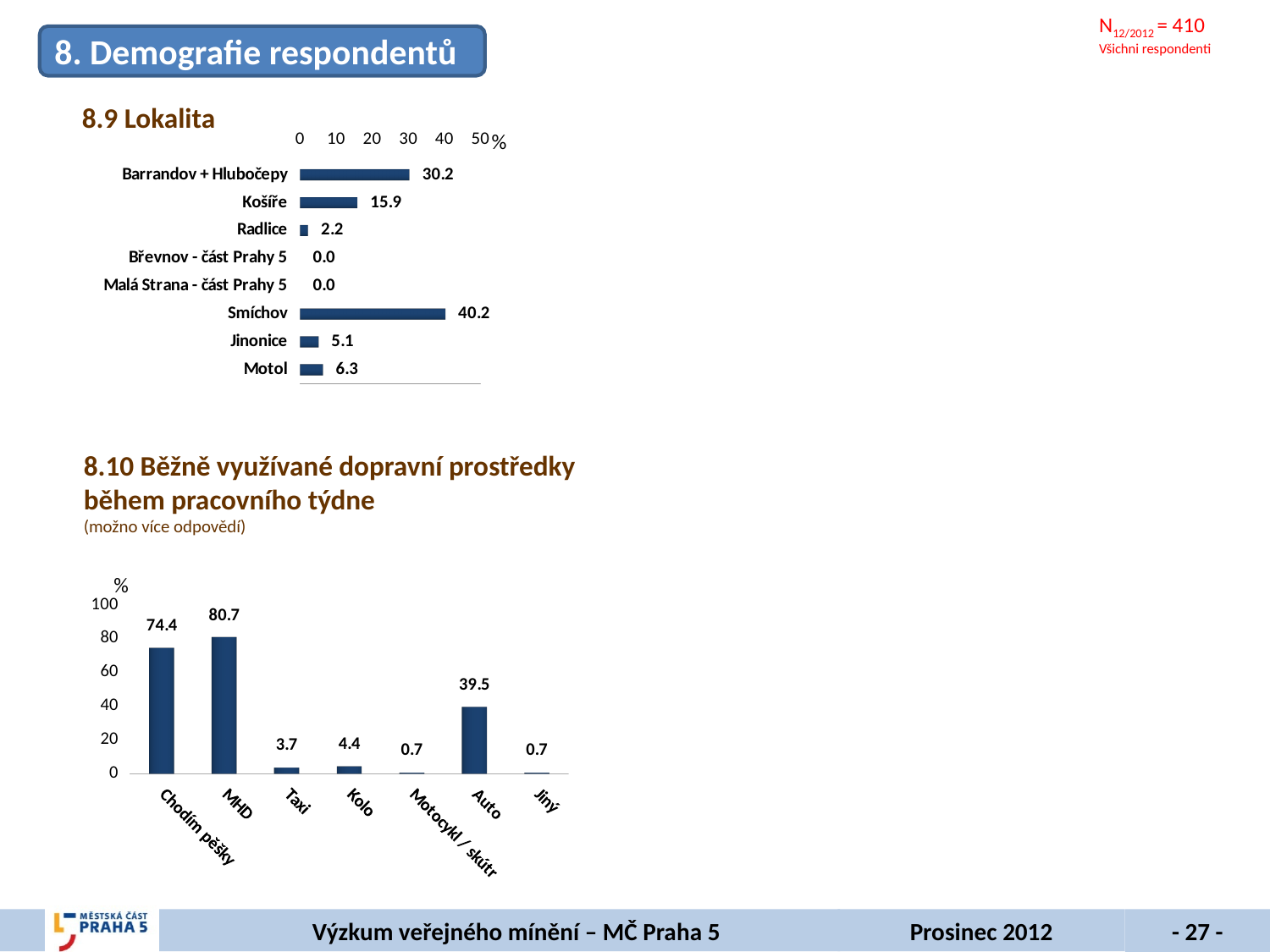
In the 8.10 chart (dopravní prostředky), what is the value for Auto? 39.5 In the 8.9 Lokalita chart, what is the value for Smíchov? 40.2 In the 8.9 Lokalita chart, what is the difference between Smíchov and Barrandov + Hlubočepy? 10.0 In the 8.9 Lokalita chart, how many localities are listed? 8 In the 8.9 Lokalita chart, which locality has the highest value? Smíchov What type of chart is the 8.10 chart (dopravní prostředky)? Bar chart In the 8.9 Lokalita chart, which is larger, Jinonice or Motol? Motol In the 8.10 chart (dopravní prostředky), what is the value for MHD? 80.7 In the 8.10 chart (dopravní prostředky), what is the difference between MHD and Chodím pěšky? 6.3 In the 8.9 Lokalita chart, how many localities have a value of 0.0? 2 In the 8.9 Lokalita chart, what is the value for Košíře? 15.9 In the 8.10 chart (dopravní prostředky), which category has the highest value? MHD